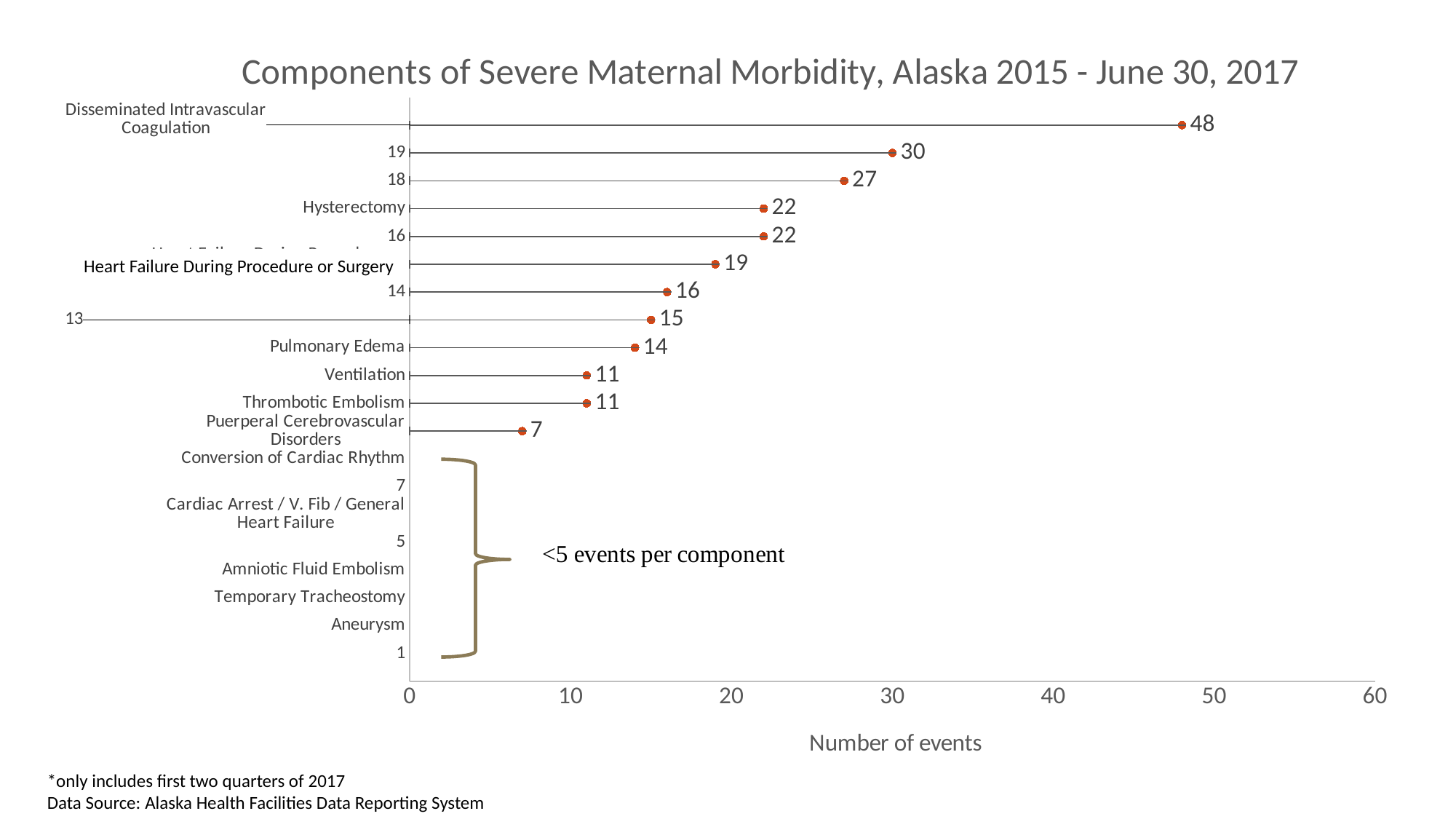
What is the number of events for Thrombotic Embolism? 11 What is the difference in number of events between Disseminated Intravascular Coagulation and Hysterectomy? 26 What is the title of the chart? Components of Severe Maternal Morbidity, Alaska 2015 - June 30, 2017 Which has more events, Pulmonary Edema or Ventilation? Pulmonary Edema What is the number of events for Hysterectomy? 22 What is the number of events for Pulmonary Edema? 14 How many events are shown for Disseminated Intravascular Coagulation? 48 Which component has the highest number of events? Disseminated Intravascular Coagulation What is the title of the x axis? Number of events What is the number of events for Heart Failure During Procedure or Surgery? 19 Is the value for Disseminated Intravascular Coagulation greater or less than 40? greater What is the number of events for Puerperal Cerebrovascular Disorders? 7